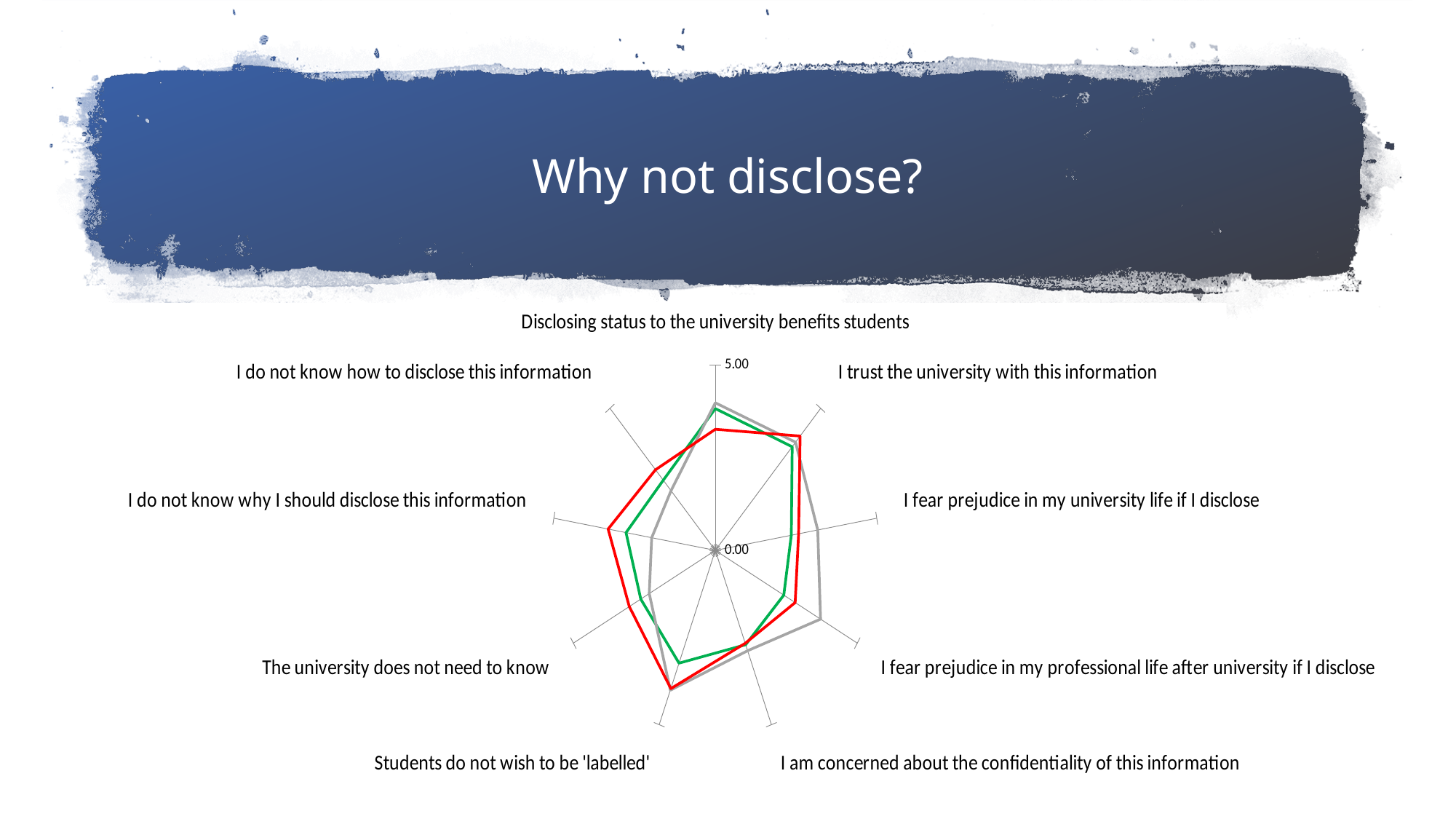
On which category does the red line reach its highest value? I trust the university with this information Which line (grey, green or red) reaches furthest on the 'I do not know how to disclose this information' axis? red How many lines (series) are plotted on the radar chart? 3 Is the value for 'I fear prejudice in my professional life after university if I disclose' on the grey line greater or less than 5.00? less On which category does the green line reach its highest value? Disclosing status to the university benefits students What kind of chart is shown on the slide? radar chart How many categories (axes) does the radar chart have? 9 Which line (grey, green or red) reaches furthest on the 'I fear prejudice in my professional life after university if I disclose' axis? grey What is the maximum value shown on the radar chart's axis? 5.00 Which line (grey, green or red) reaches furthest on the 'I fear prejudice in my university life if I disclose' axis? grey Is the value for 'Students do not wish to be 'labelled'' on the red line greater or less than 5.00? less